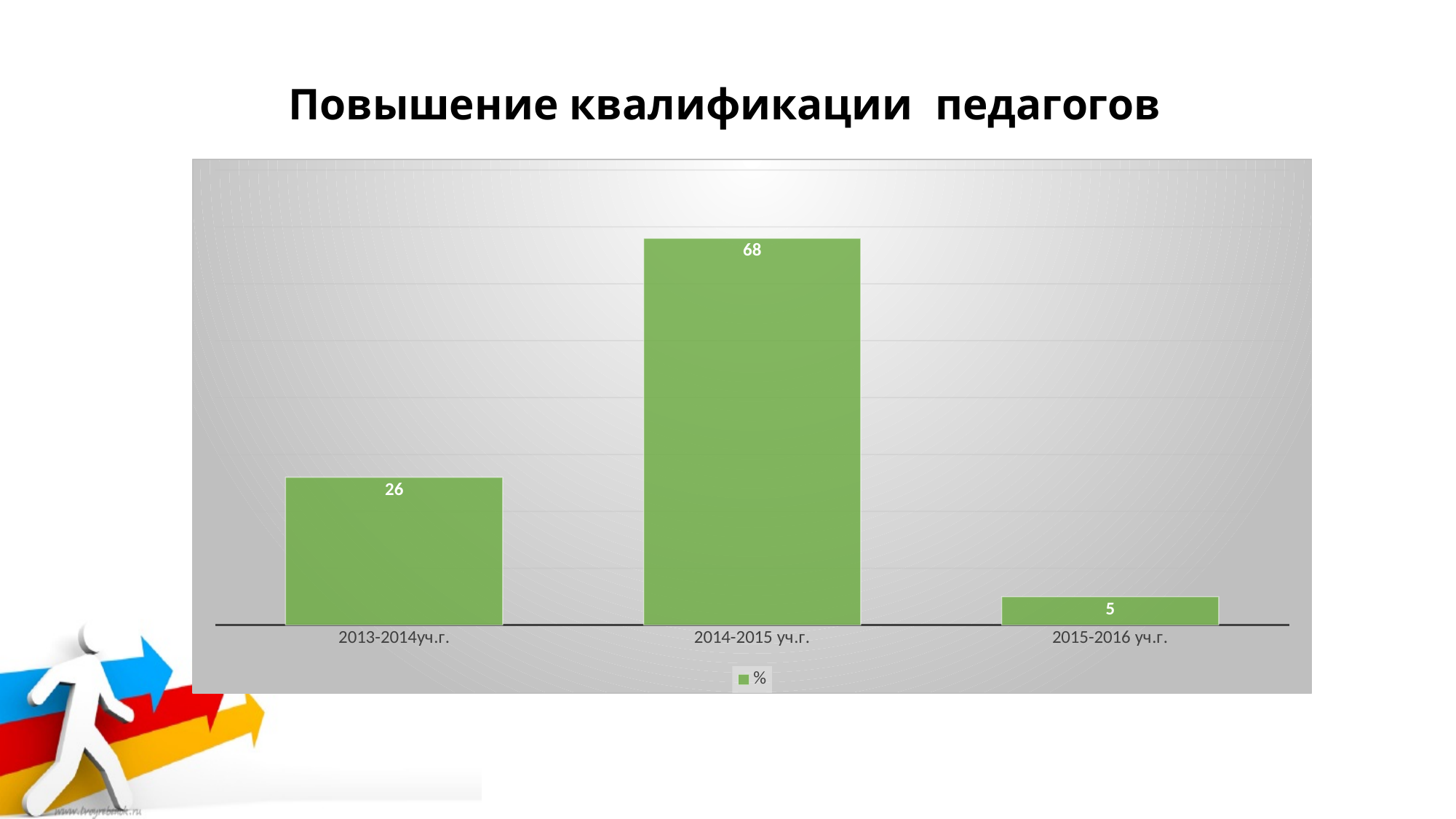
What is the title of the slide? Повышение квалификации педагогов Which is larger, the value for 2013-2014уч.г. or the value for 2015-2016 уч.г.? 2013-2014уч.г. What is the value for 2013-2014уч.г.? 26 What is the difference between the values for 2013-2014уч.г. and 2015-2016 уч.г.? 21 How many categories are shown on the x axis? 3 What is the difference between the values for 2014-2015 уч.г. and 2013-2014уч.г.? 42 Which category has the lowest value? 2015-2016 уч.г. Which category has the highest value? 2014-2015 уч.г. What kind of chart is shown on the slide? bar chart What is the value for 2014-2015 уч.г.? 68 What is the value for 2015-2016 уч.г.? 5 How many series does the legend list? 1